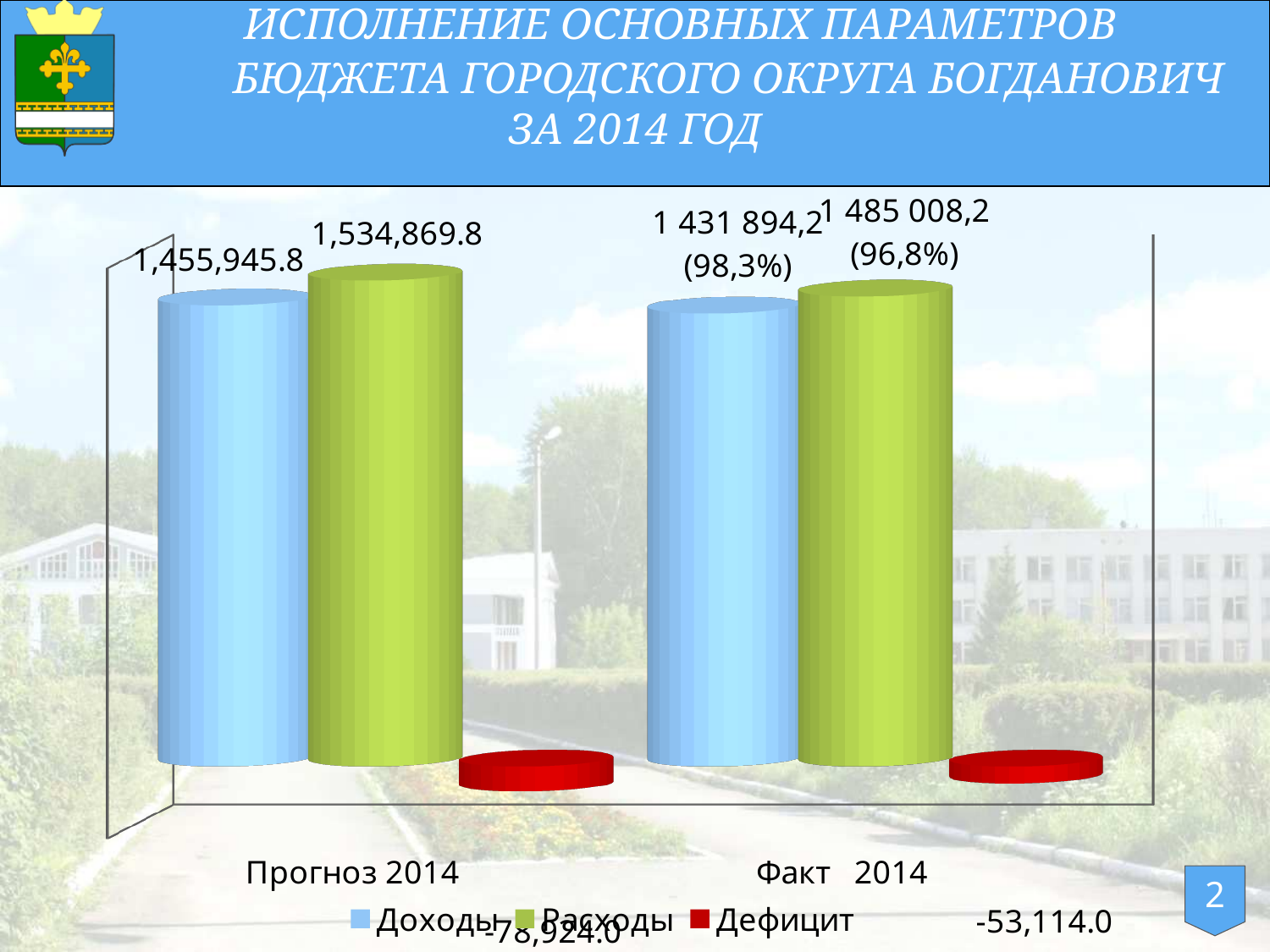
Which is larger for Факт 2014, Доходы or Расходы? Расходы How many series does the legend list? 3 What is the value of Расходы for Прогноз 2014? 1,534,869.8 What kind of chart is shown on the slide? Bar chart What is the value of Расходы for Факт 2014? 1 485 008,2 What is the difference between Расходы and Доходы for Прогноз 2014? 78,924.0 What percentage is shown next to the Расходы value for Факт 2014? 96,8% What is the value of Доходы for Факт 2014? 1 431 894,2 What is the value of Доходы for Прогноз 2014? 1,455,945.8 What is the value of Дефицит for Факт 2014? -53,114.0 How many categories are shown on the x axis? 2 What percentage is shown next to the Доходы value for Факт 2014? 98,3%